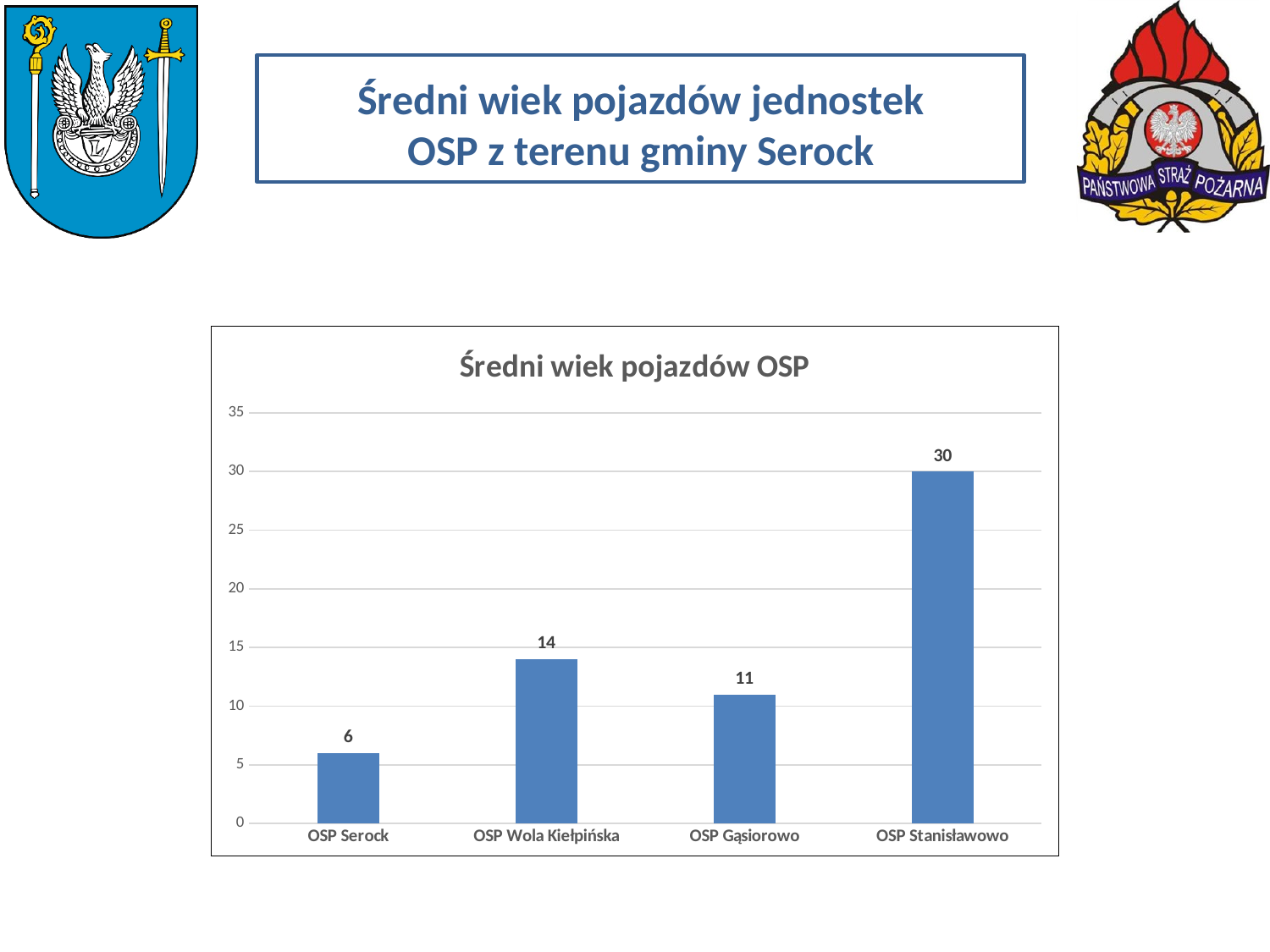
What is the title of the chart? Średni wiek pojazdów OSP What is the average vehicle age for OSP Gąsiorowo? 11 What is the average vehicle age for OSP Wola Kiełpińska? 14 Which has a higher average vehicle age, OSP Wola Kiełpińska or OSP Gąsiorowo? OSP Wola Kiełpińska What is the difference between the average vehicle age of OSP Wola Kiełpińska and OSP Gąsiorowo? 3 What is the difference between the average vehicle age of OSP Stanisławowo and OSP Serock? 24 What type of chart is shown on the slide? bar chart Which unit has the lowest average vehicle age? OSP Serock What is the average vehicle age for OSP Serock? 6 How many units are shown on the chart? 4 Which unit has the highest average vehicle age? OSP Stanisławowo What is the average vehicle age for OSP Stanisławowo? 30